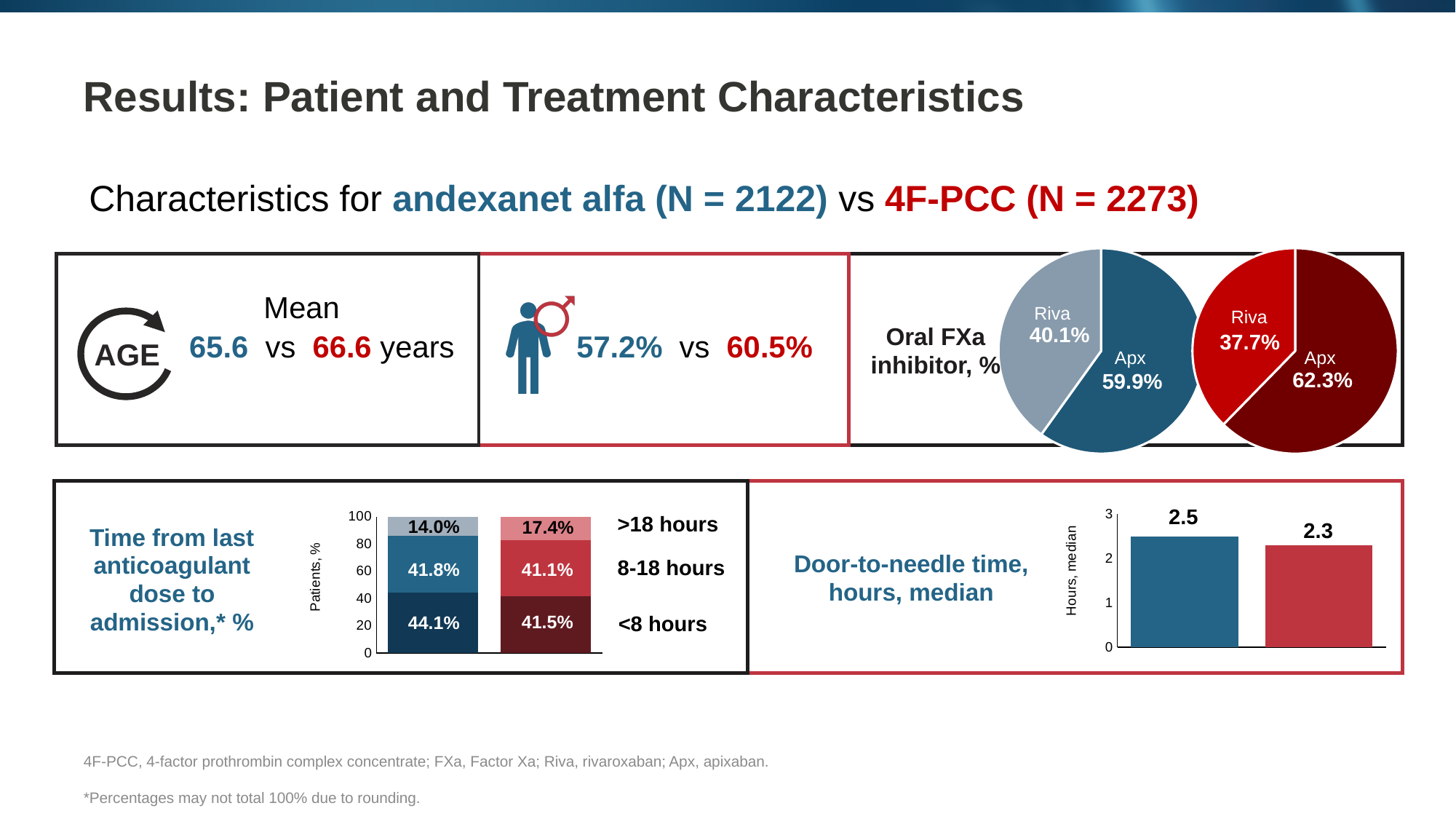
In the 'Time from last anticoagulant dose to admission' chart, what kind of chart is shown? Stacked bar chart In the 'Time from last anticoagulant dose to admission' chart, what is the value for '>18 hours' in the 4F-PCC (red) bar? 17.4% In the 'Door-to-needle time, hours, median' chart, which bar is higher, andexanet alfa (blue) or 4F-PCC (red)? andexanet alfa In the 'Oral FXa inhibitor, %' pie chart for andexanet alfa (blue), which slice is larger, Apx or Riva? Apx In the 'Time from last anticoagulant dose to admission' chart, what is the difference between the '8-18 hours' values for andexanet alfa and 4F-PCC? 0.7% In the 'Door-to-needle time, hours, median' chart, what is the y-axis label? Hours, median In the 'Oral FXa inhibitor, %' pie chart for 4F-PCC (red), what share is Riva? 37.7% In the 'Time from last anticoagulant dose to admission' chart, which segment is the smallest in the andexanet alfa (blue) bar? >18 hours In the 'Time from last anticoagulant dose to admission' chart, what is the value for '<8 hours' in the andexanet alfa (blue) bar? 44.1% In the 'Oral FXa inhibitor, %' pie chart for 4F-PCC (red), how many slices are there? 2 In the 'Oral FXa inhibitor, %' pie chart for andexanet alfa (blue), what share is Apx? 59.9% In the 'Door-to-needle time, hours, median' chart, what is the value for 4F-PCC (red bar)? 2.3